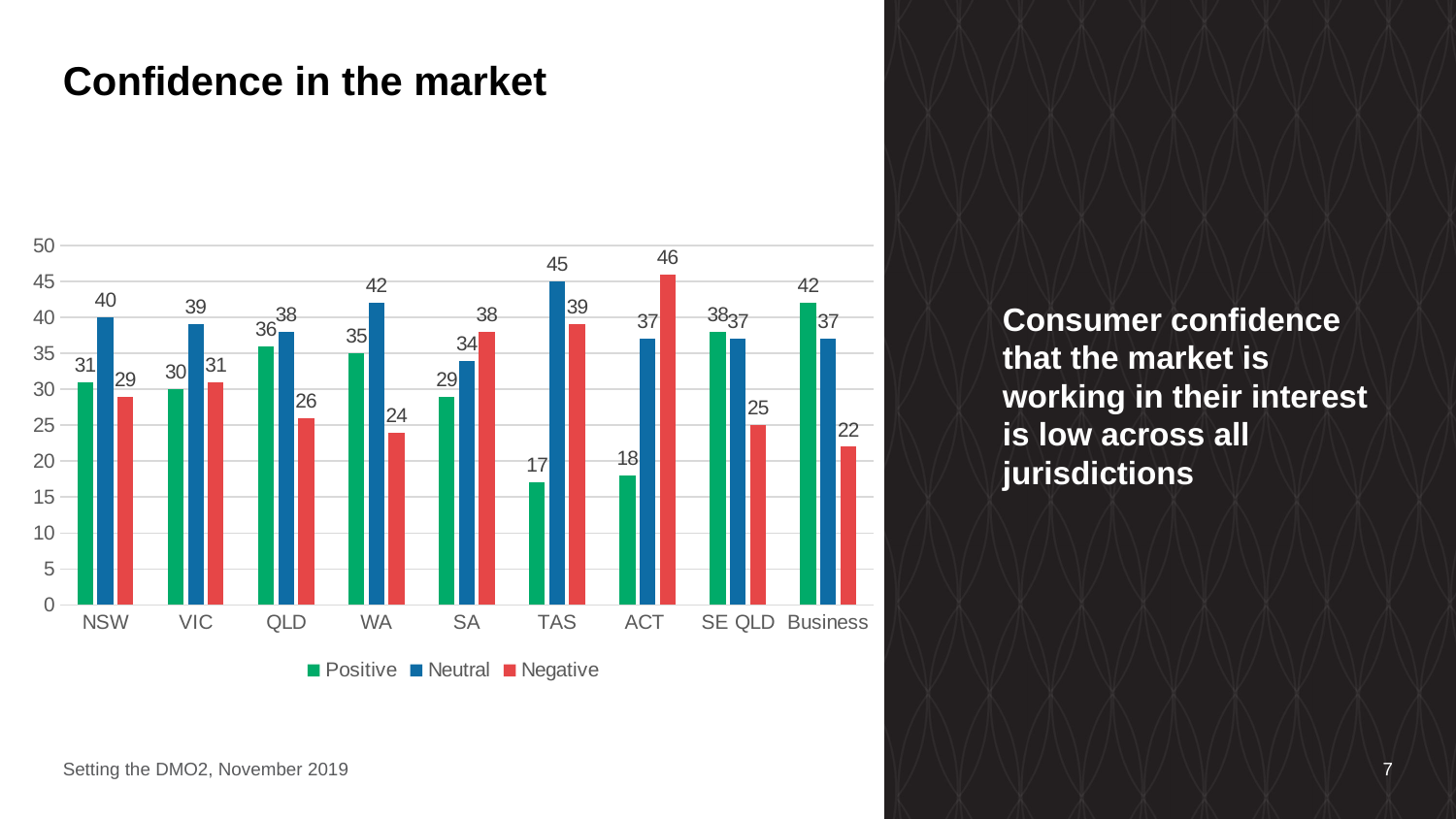
What is the difference between the Neutral and Positive values for TAS? 28 How many categories are shown on the x axis? 9 How many series does the legend list? 3 What is the title of the slide containing the chart? Confidence in the market Which is larger for SA, the Negative value or the Positive value? Negative What is the Negative value for ACT? 46 Which category has the highest Positive value? Business What kind of chart is shown on the slide? Bar chart Which category has the lowest Positive value? TAS What is the Neutral value for WA? 42 What is the Positive value for NSW? 31 Which category has the highest Negative value? ACT